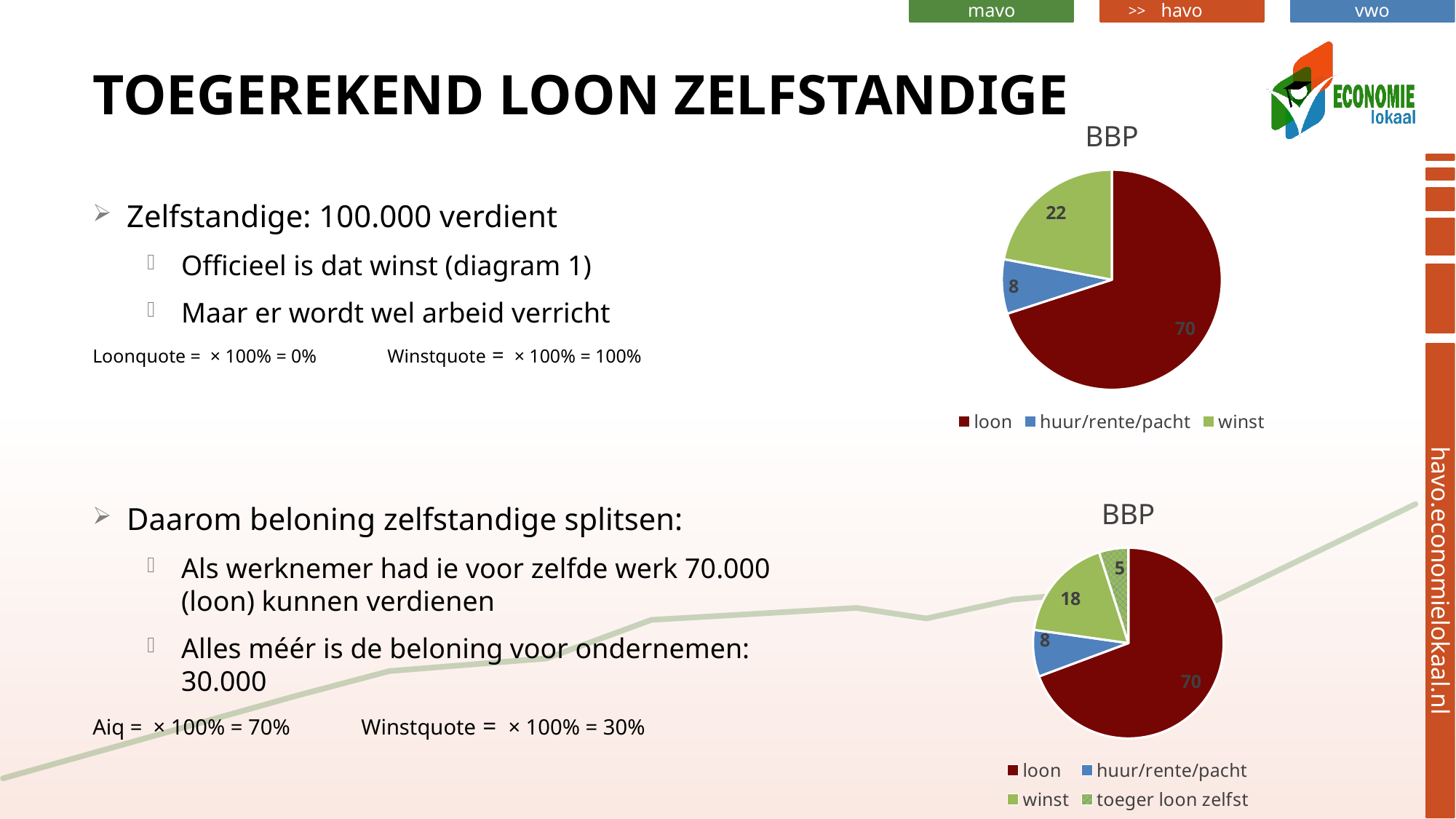
In the bottom pie chart, which is larger, winst or huur/rente/pacht? winst In the top pie chart, which category has the smallest slice? huur/rente/pacht In the top pie chart, what share of the pie does loon represent? 70% In the bottom pie chart, what is the value for winst? 18 In the top pie chart, what is the value for winst? 22 In the bottom pie chart, what is the value for toeger loon zelfst? 5 In the top pie chart, what is the value for loon? 70 In the top pie chart, what is the difference between the values for loon and winst? 48 What type of chart is shown at the top right of the slide? pie chart In the top pie chart, what is the value for huur/rente/pacht? 8 In the top pie chart, which category has the largest slice? loon How many categories does the legend of the bottom pie chart list? 4